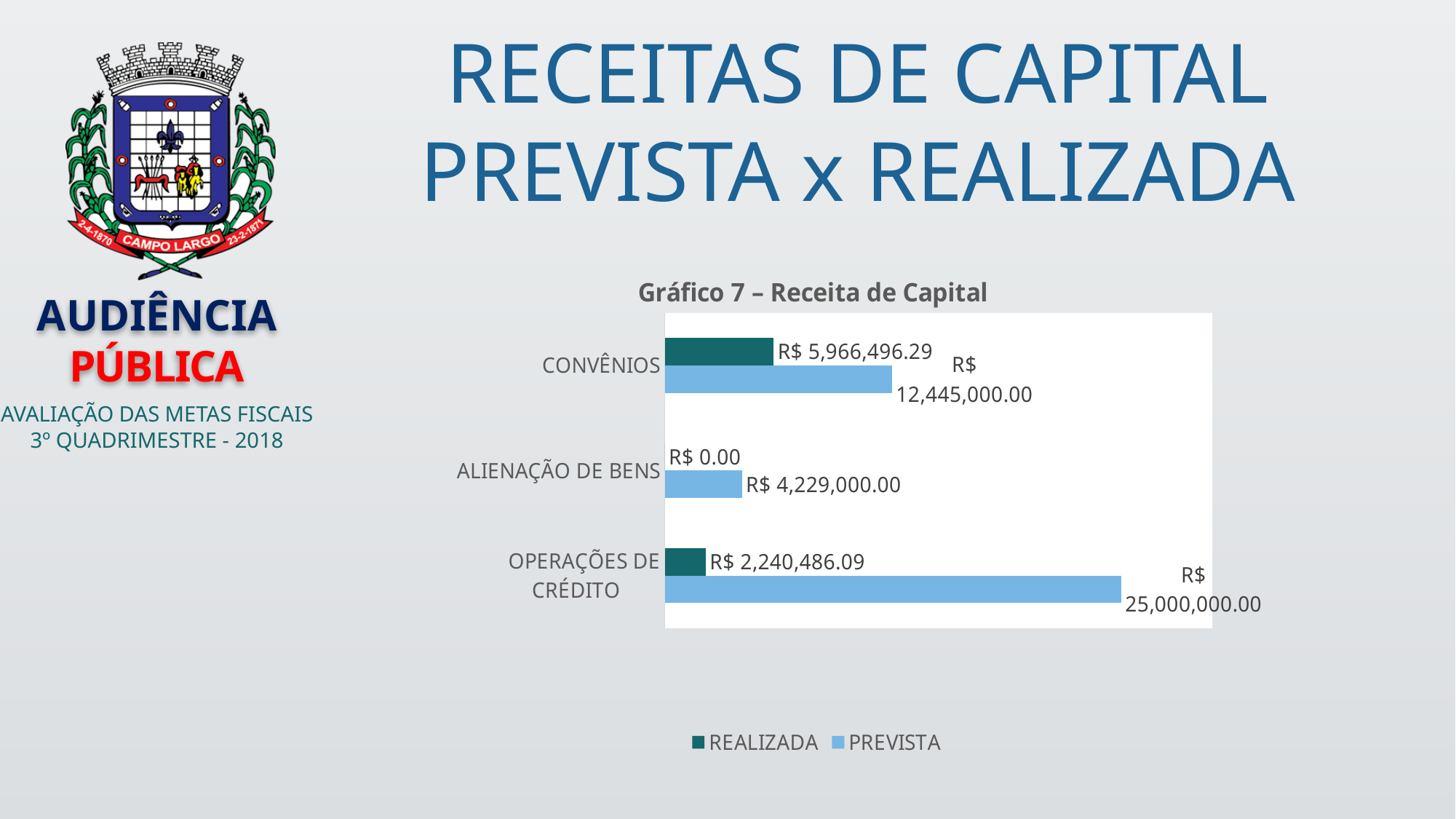
Which category has the highest PREVISTA value? OPERAÇÕES DE CRÉDITO How many series does the legend list? 2 What is the PREVISTA value for ALIENAÇÃO DE BENS? R$ 4,229,000.00 What is the REALIZADA value for ALIENAÇÃO DE BENS? R$ 0.00 What type of chart is shown on the slide? Bar chart What is the PREVISTA value for OPERAÇÕES DE CRÉDITO? R$ 25,000,000.00 What is the difference between the PREVISTA and REALIZADA values for CONVÊNIOS? R$ 6,478,503.71 What is the difference between the PREVISTA and REALIZADA values for OPERAÇÕES DE CRÉDITO? R$ 22,759,513.91 Which category has the lowest REALIZADA value? ALIENAÇÃO DE BENS Which is larger: the REALIZADA value for CONVÊNIOS or the REALIZADA value for OPERAÇÕES DE CRÉDITO? CONVÊNIOS How many categories are shown in the chart? 3 What is the REALIZADA value for CONVÊNIOS? R$ 5,966,496.29